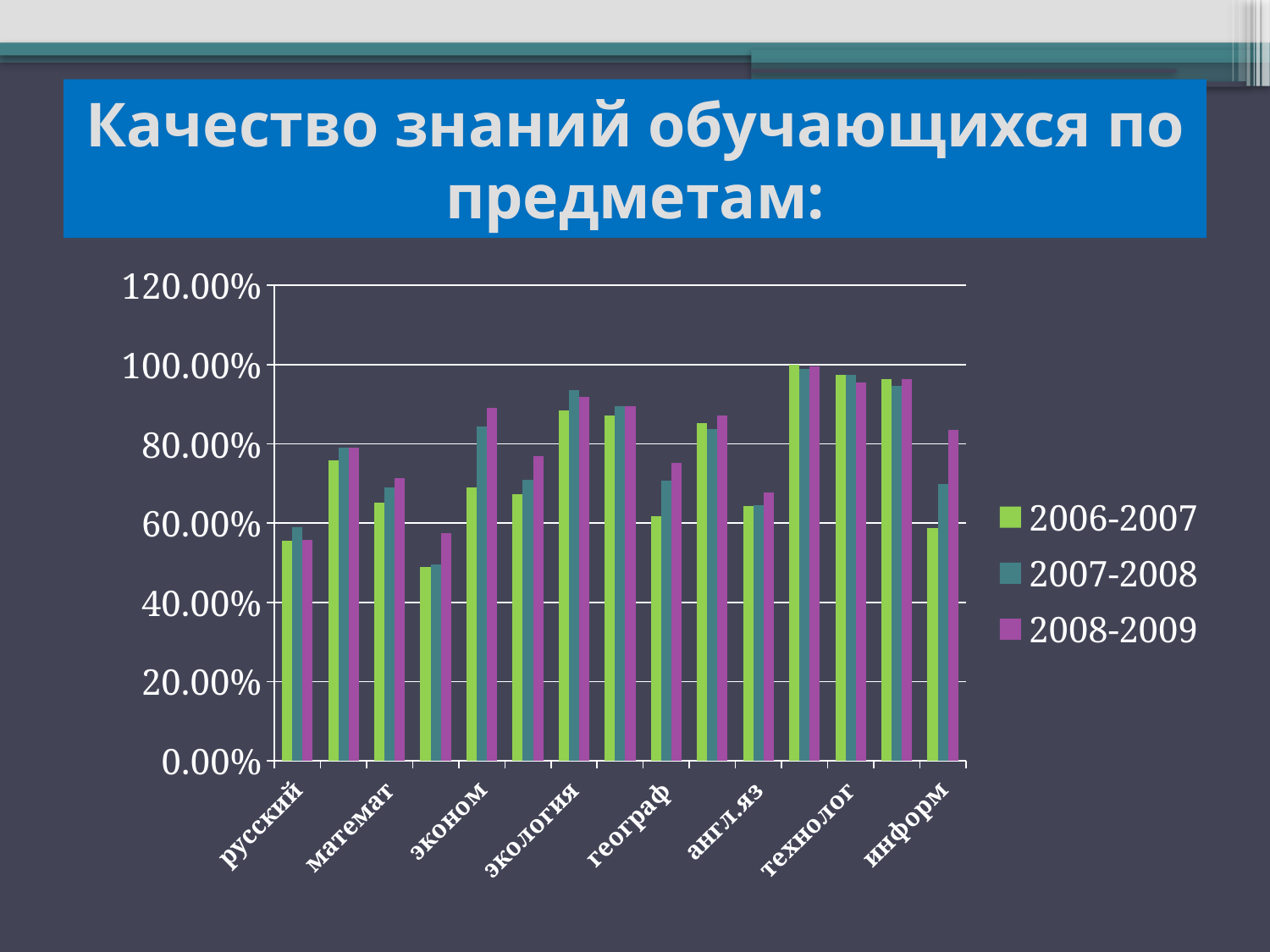
Is the 2007-2008 value for экология greater or less than 60.00%? greater Is the 2006-2007 value for технолог greater or less than 80.00%? greater What are the series names listed in the legend? 2006-2007, 2007-2008, 2008-2009 Is the 2008-2009 value for математ greater or less than 60.00%? greater Which is larger for 2006-2007: the value for эконом or the value for экология? экология How many series does the legend list? 3 Which is larger for 2006-2007: the value for русский or the value for технолог? технолог What is the title of the chart on the slide? Качество знаний обучающихся по предметам: What kind of chart is shown on the slide? bar chart